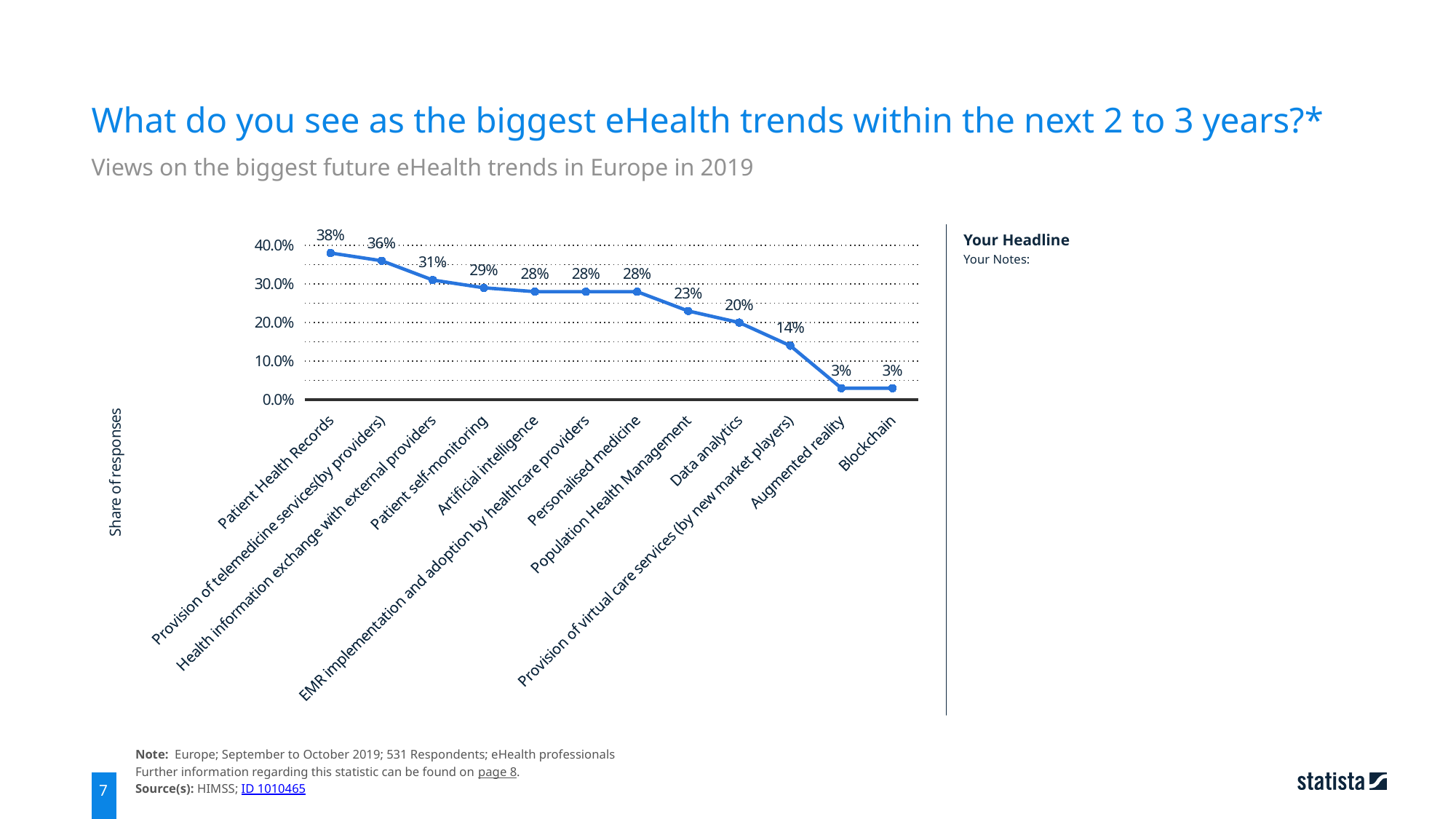
Is the value for Health information exchange with external providers greater or less than 30.0%? greater What is the difference between the share for Patient Health Records and the share for Blockchain? 35% What share of responses is shown for Data analytics? 20% Do the values rise or fall from left to right along the x axis? Fall How many categories are plotted on the chart? 12 What kind of chart is shown on the slide? Line chart Which has a larger share of responses, Patient self-monitoring or Data analytics? Patient self-monitoring What share of responses is shown for Provision of virtual care services (by new market players)? 14% What share of responses is shown for Patient Health Records? 38% What is the label on the vertical axis of the chart? Share of responses What is the difference between the share for Provision of telemedicine services (by providers) and the share for Population Health Management? 13% Which category has the highest share of responses? Patient Health Records